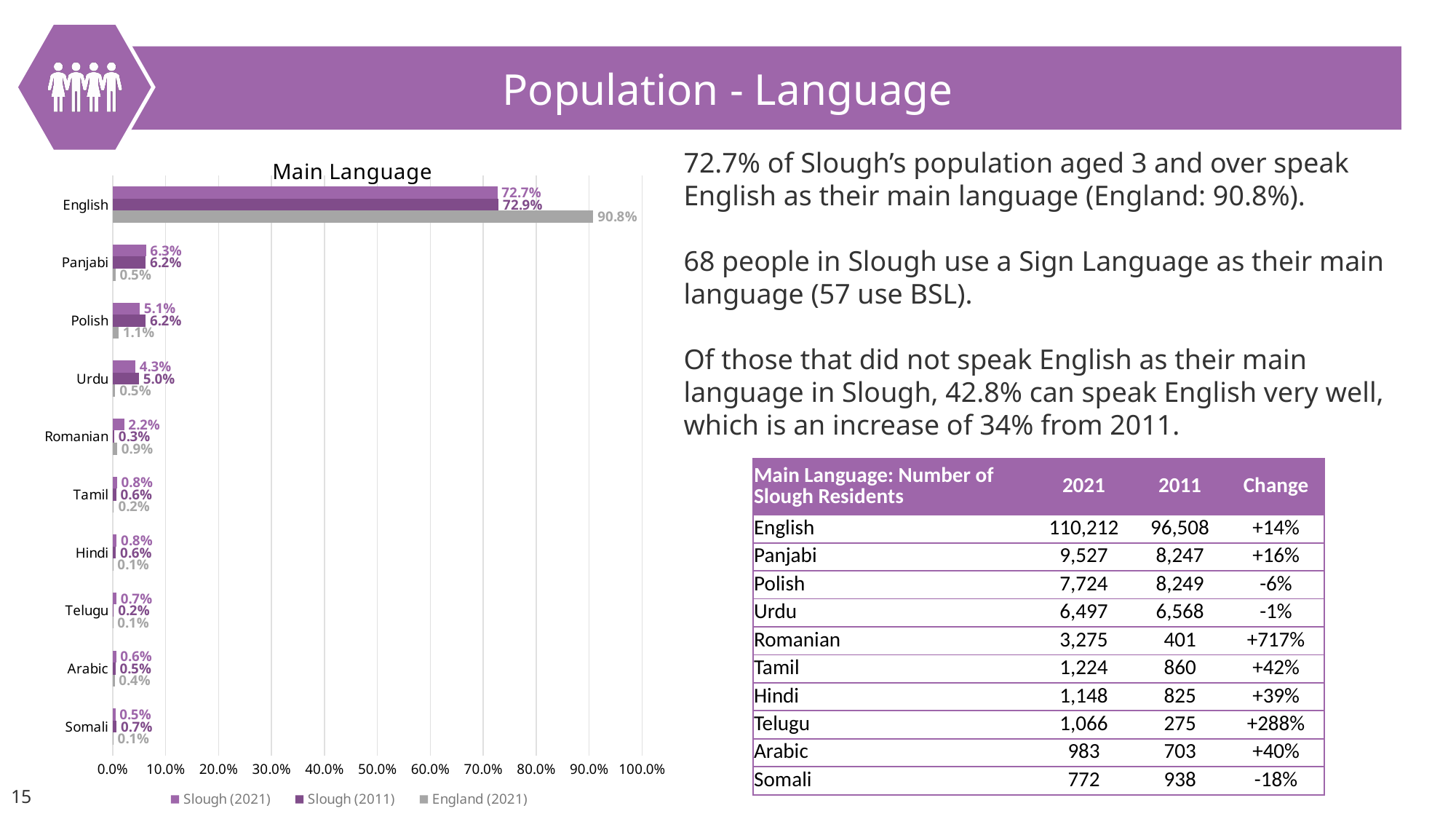
How many languages are shown in the Main Language chart? 10 What type of chart is the Main Language chart? bar chart Which language has the highest Slough (2021) value in the Main Language chart? English What is the Slough (2021) value for Romanian in the Main Language chart? 2.2% In the Main Language chart, is the Slough (2021) value for Panjabi larger or smaller than the Slough (2021) value for Polish? larger What is the difference between the England (2021) and Slough (2021) values for English in the Main Language chart? 18.1% Is the England (2021) value for English in the Main Language chart greater or less than 80.0%? greater What is the Slough (2011) value for Polish in the Main Language chart? 6.2% Which language has the lowest Slough (2021) value in the Main Language chart? Somali How many series does the legend of the Main Language chart list? 3 What is the Slough (2021) value for English in the Main Language chart? 72.7% What is the England (2021) value for English in the Main Language chart? 90.8%